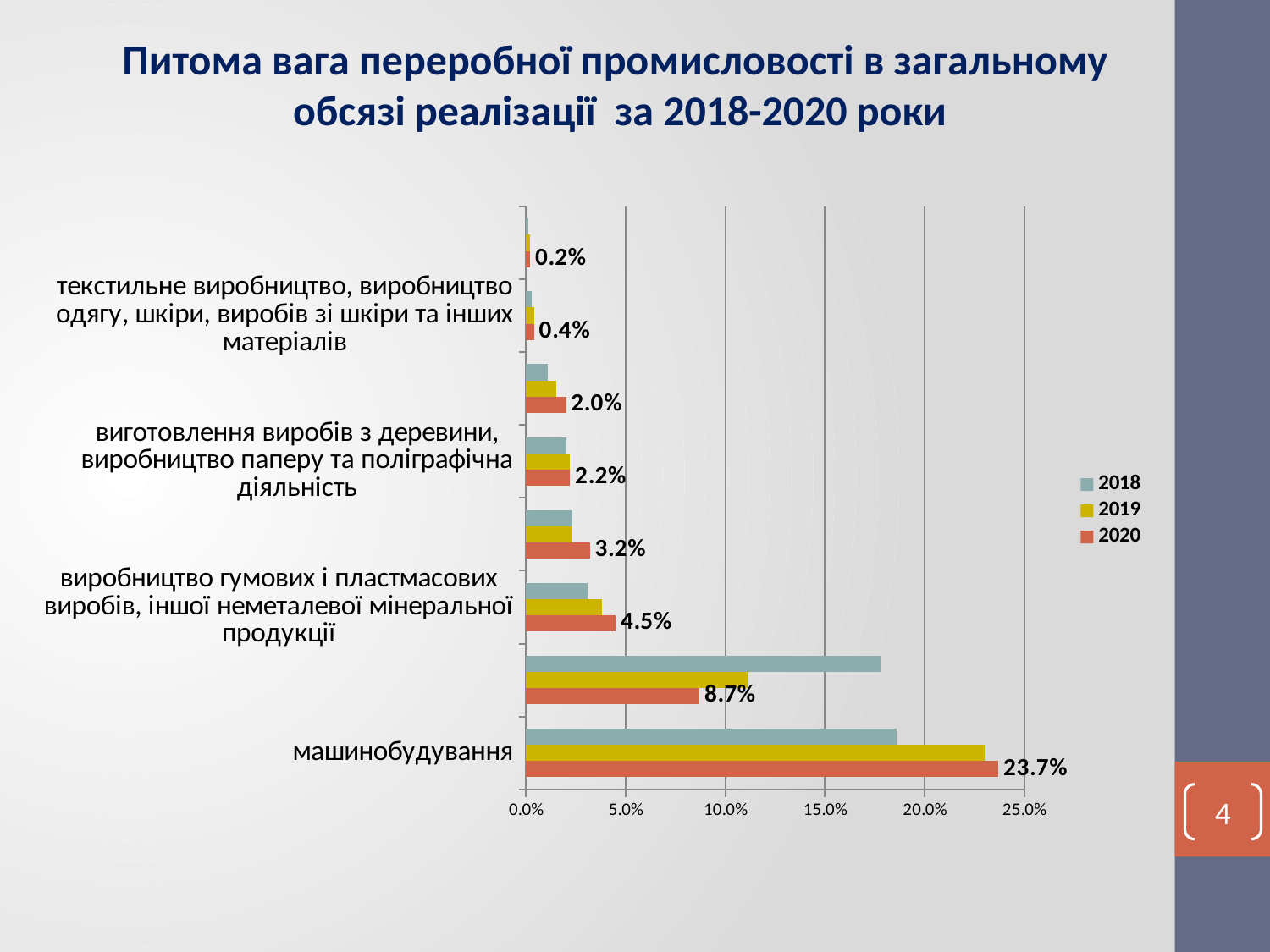
What is the 2020 value for текстильне виробництво, виробництво одягу, шкіри, виробів зі шкіри та інших матеріалів? 0.4% What kind of chart is shown on the slide? bar chart What is the 2020 value for виробництво гумових і пластмасових виробів, іншої неметалевої мінеральної продукції? 4.5% Is the 2019 value for машинобудування greater or less than 20.0%? greater For машинобудування, which is larger: the 2019 value or the 2020 value? 2020 Which category has the highest 2020 value? машинобудування Is the 2018 value for машинобудування greater or less than 20.0%? less Which years are listed in the legend? 2018, 2019, 2020 What is the 2020 value for машинобудування? 23.7% What is the difference between the 2020 values for машинобудування and виробництво гумових і пластмасових виробів, іншої неметалевої мінеральної продукції? 19.2% What is the 2020 value for виготовлення виробів з деревини, виробництво паперу та поліграфічна діяльність? 2.2% How many series does the legend list? 3